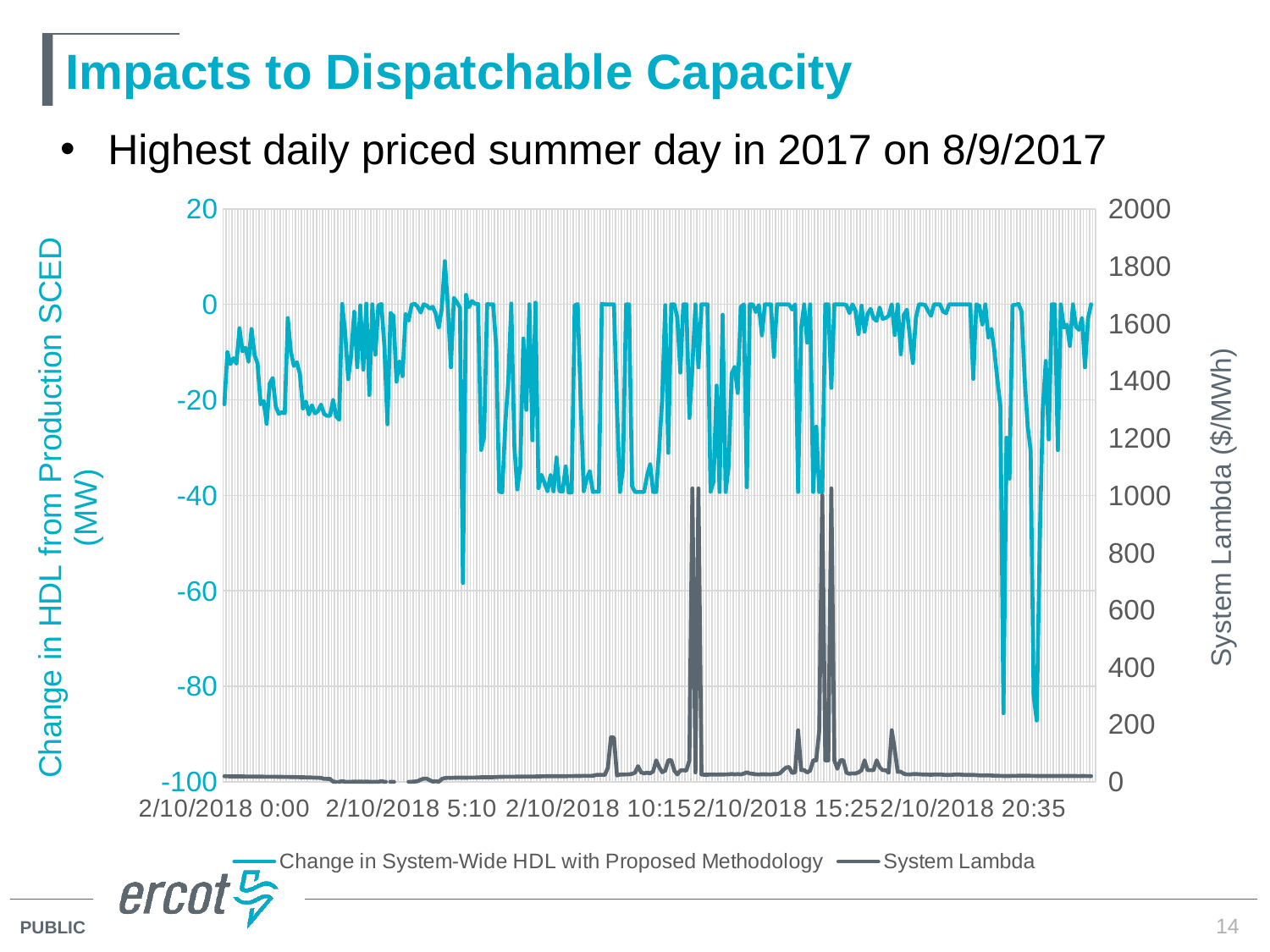
What kind of chart is shown on the slide? line chart What is the title of the right-hand vertical axis? System Lambda ($/MWh) How many series does the chart legend list? 2 Is the Change in System-Wide HDL value at 2/10/2018 0:00 greater or less than -40? greater Is the lowest value of the Change in System-Wide HDL series greater or less than -60? less Is the System Lambda value at 2/10/2018 0:00 greater or less than 200? less What are the two series named in the chart legend? Change in System-Wide HDL with Proposed Methodology; System Lambda How many date/time labels are shown along the x axis? 5